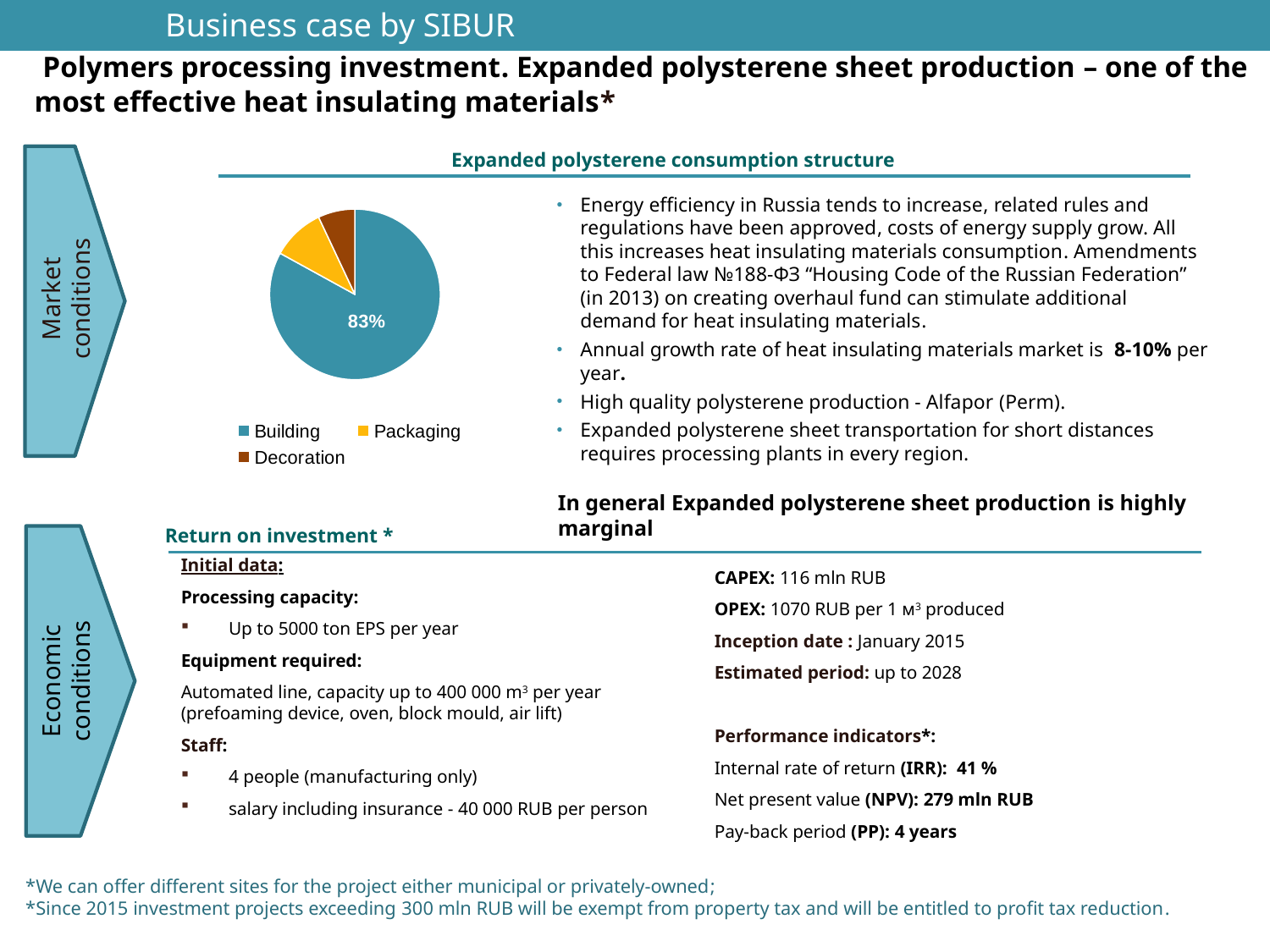
What kind of chart is shown under "Expanded polysterene consumption structure"? Pie chart Which category has the smallest slice in the expanded polysterene consumption pie chart? Decoration How many entries does the legend of the pie chart list? 3 In the pie chart, which is larger: the Building slice or the Packaging slice? Building What value is printed as a data label on the pie chart? 83% What is the title of the pie chart on the slide? Expanded polysterene consumption structure Which colour represents Packaging in the pie chart? Yellow Which category has the largest slice in the expanded polysterene consumption pie chart? Building What share of expanded polysterene consumption does Building account for in the pie chart? 83% How many categories are shown in the expanded polysterene consumption pie chart? 3 In the pie chart, which is larger: the Packaging slice or the Decoration slice? Packaging